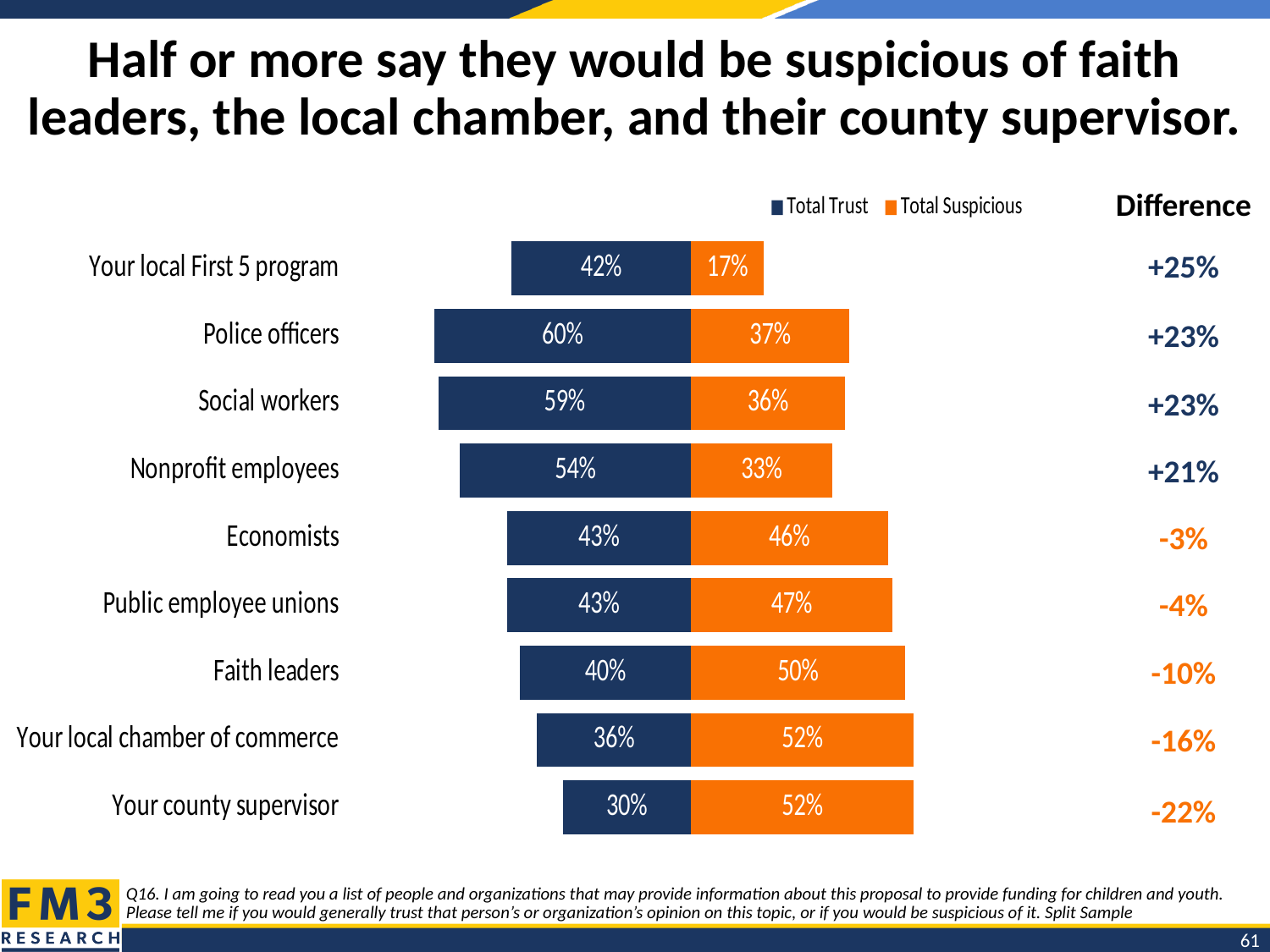
What is the Total Trust value for Police officers? 60% How many categories are shown in the chart? 9 What is the Difference value shown for Your county supervisor? -22% What is the difference between Total Trust and Total Suspicious for Nonprofit employees? 21% Which category has the highest Total Trust value? Police officers Which category has the lowest Total Trust value? Your county supervisor Which category has the lowest Total Suspicious value? Your local First 5 program What kind of chart is shown on the slide? Bar chart How many series does the legend list? 2 What is the Total Suspicious value for Your local First 5 program? 17% What is the Total Suspicious value for Faith leaders? 50% Which is larger for Economists: Total Trust or Total Suspicious? Total Suspicious